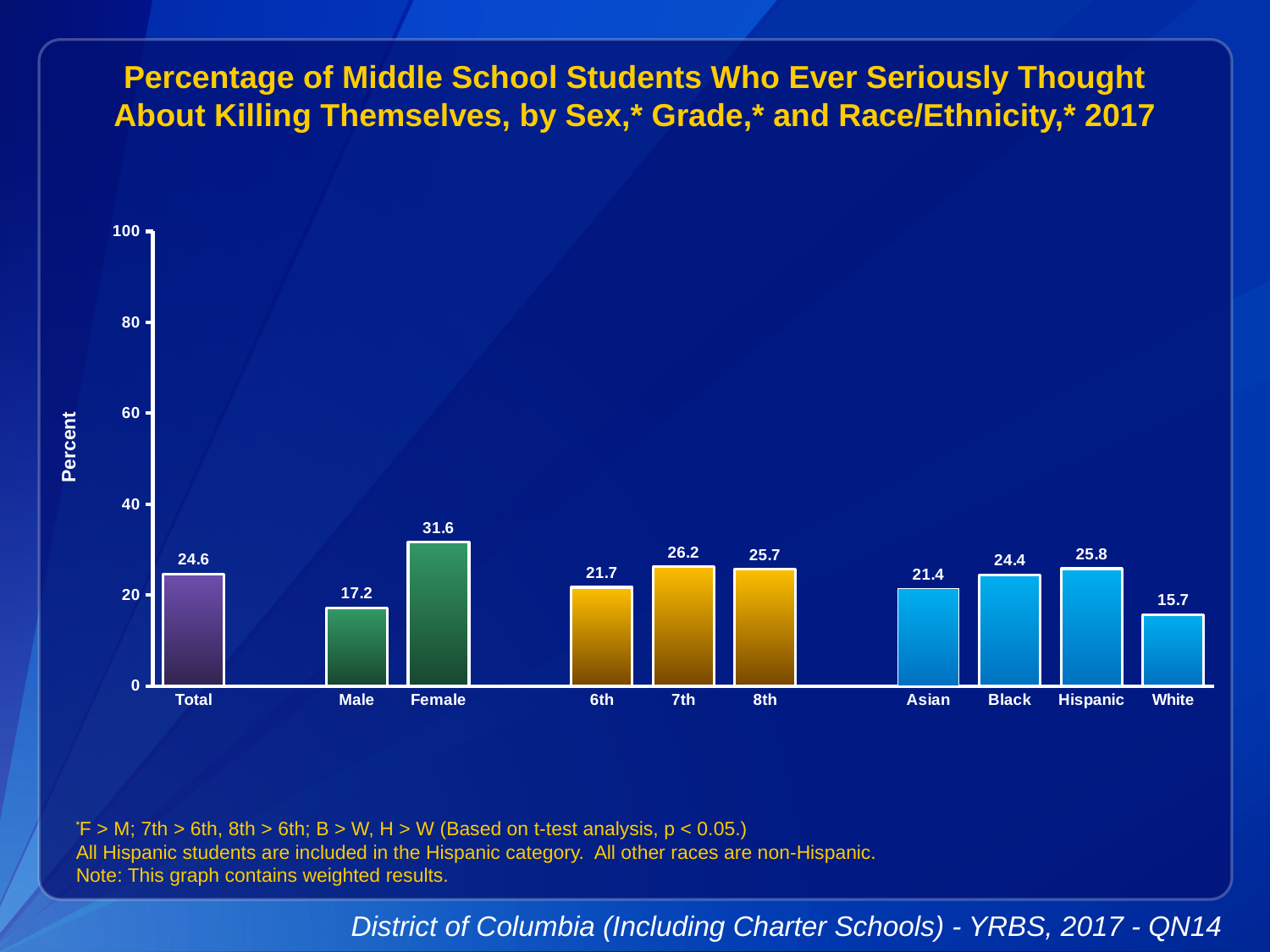
Which is larger, the value for Black or the value for Asian? Black What is the value for 7th grade? 26.2 What is the value for White? 15.7 Which category has the highest value? Female What is the value for Female? 31.6 What kind of chart is shown on the slide? Bar chart Is the value for 6th grade greater or less than 20? greater What is the label on the vertical axis? Percent What is the value for Total? 24.6 Which category has the lowest value? White How many bars are shown in the chart? 10 What is the difference between the Female and Male values? 14.4